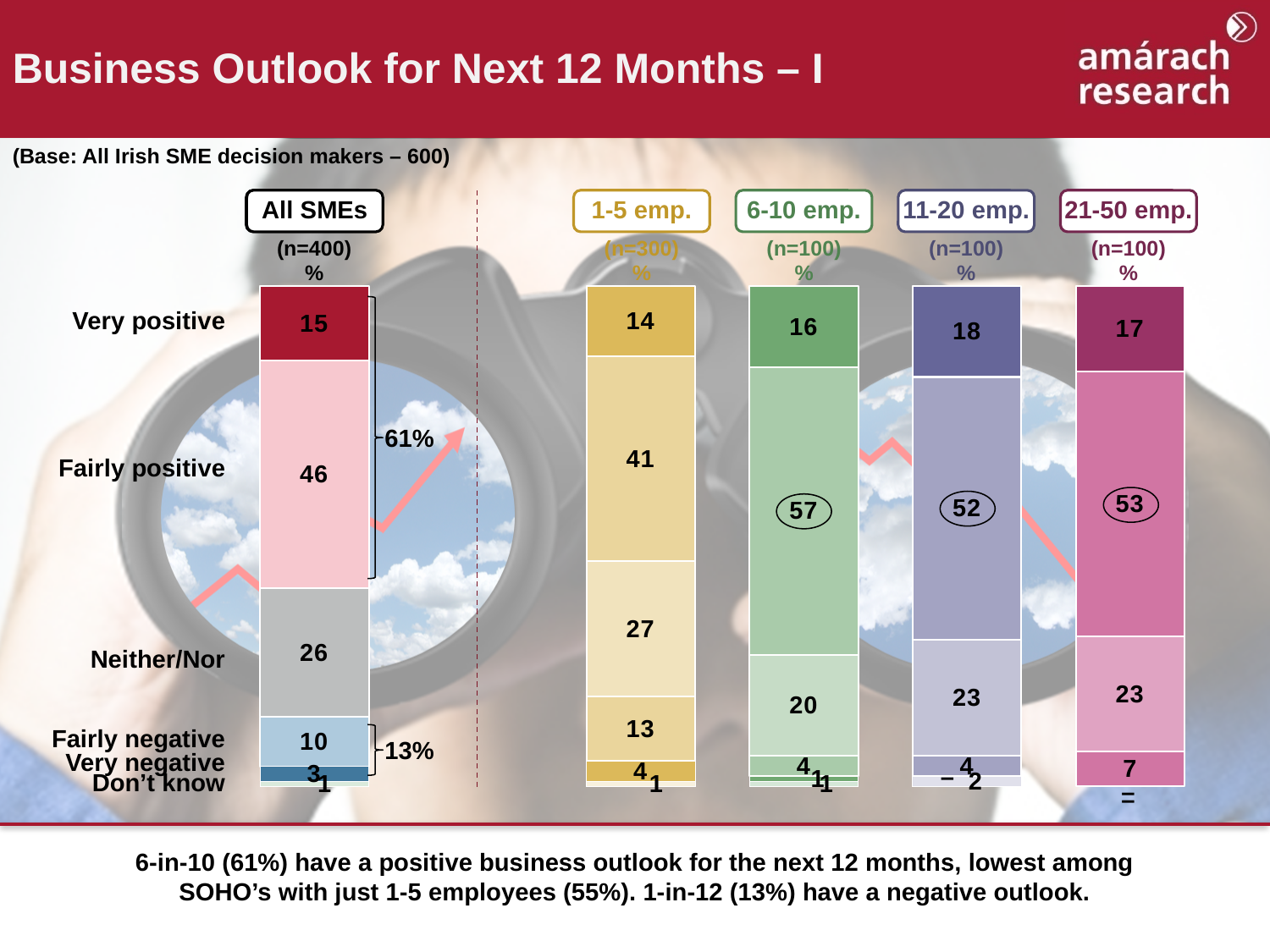
What combined percentage of All SMEs have a negative outlook, as shown by the bracket? 13% What type of chart is used on this slide? Stacked bar chart What combined percentage of All SMEs have a positive outlook (Very positive plus Fairly positive), as shown by the bracket? 61% What is the difference between the 'Fairly positive' values for the 6-10 emp. and 11-20 emp. groups? 5 What is the 'Fairly negative' value for the 21-50 emp. group? 7 How many employee-size groups are shown to the right of the dashed line? 4 What is the 'Neither/Nor' value for the 1-5 emp. group? 27 Which employee-size group has the lowest 'Fairly positive' value? 1-5 emp. Which employee-size group has the highest 'Very positive' value? 11-20 emp. What is the 'Fairly positive' value for the 6-10 emp. group? 57 Is the 'Fairly negative' value larger for the 1-5 emp. group or the 6-10 emp. group? 1-5 emp. What percentage of All SMEs are 'Very positive' about the business outlook for the next 12 months? 15